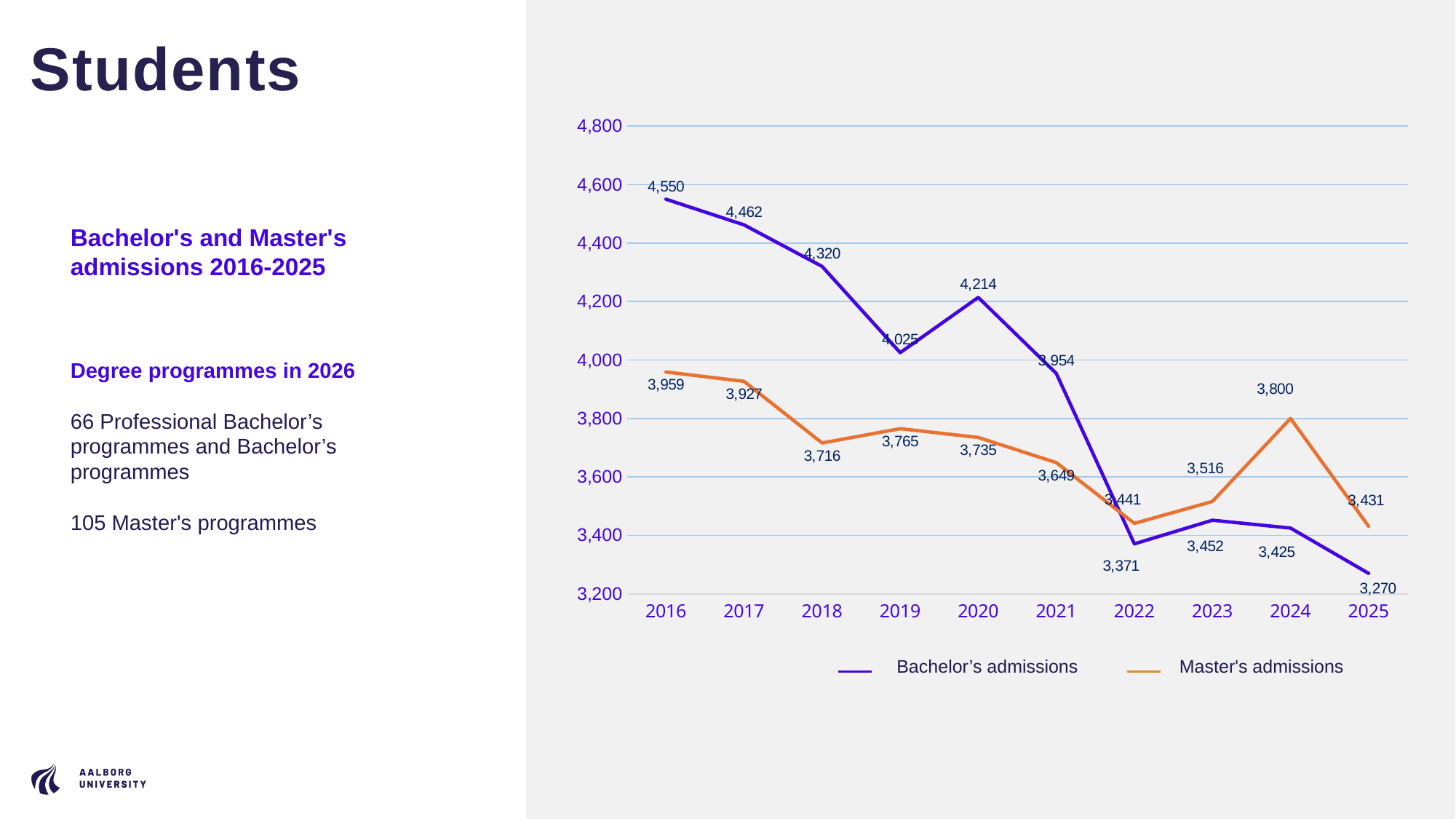
What is the difference between Bachelor's admissions in 2016 and 2025? 1,280 What was the value for Bachelor's admissions in 2016? 4,550 In which year were Bachelor's admissions lowest? 2025 How many years are plotted on the x axis? 10 What was the value for Bachelor's admissions in 2022? 3,371 In which year were Master's admissions highest? 2016 What colour is the line for Master's admissions? Orange What type of chart is shown on the slide? Line chart How many series does the legend list? 2 Do Bachelor's admissions generally rise or fall from 2016 to 2025? Fall What was the value for Master's admissions in 2024? 3,800 Which was larger in 2024, Bachelor's admissions or Master's admissions? Master's admissions